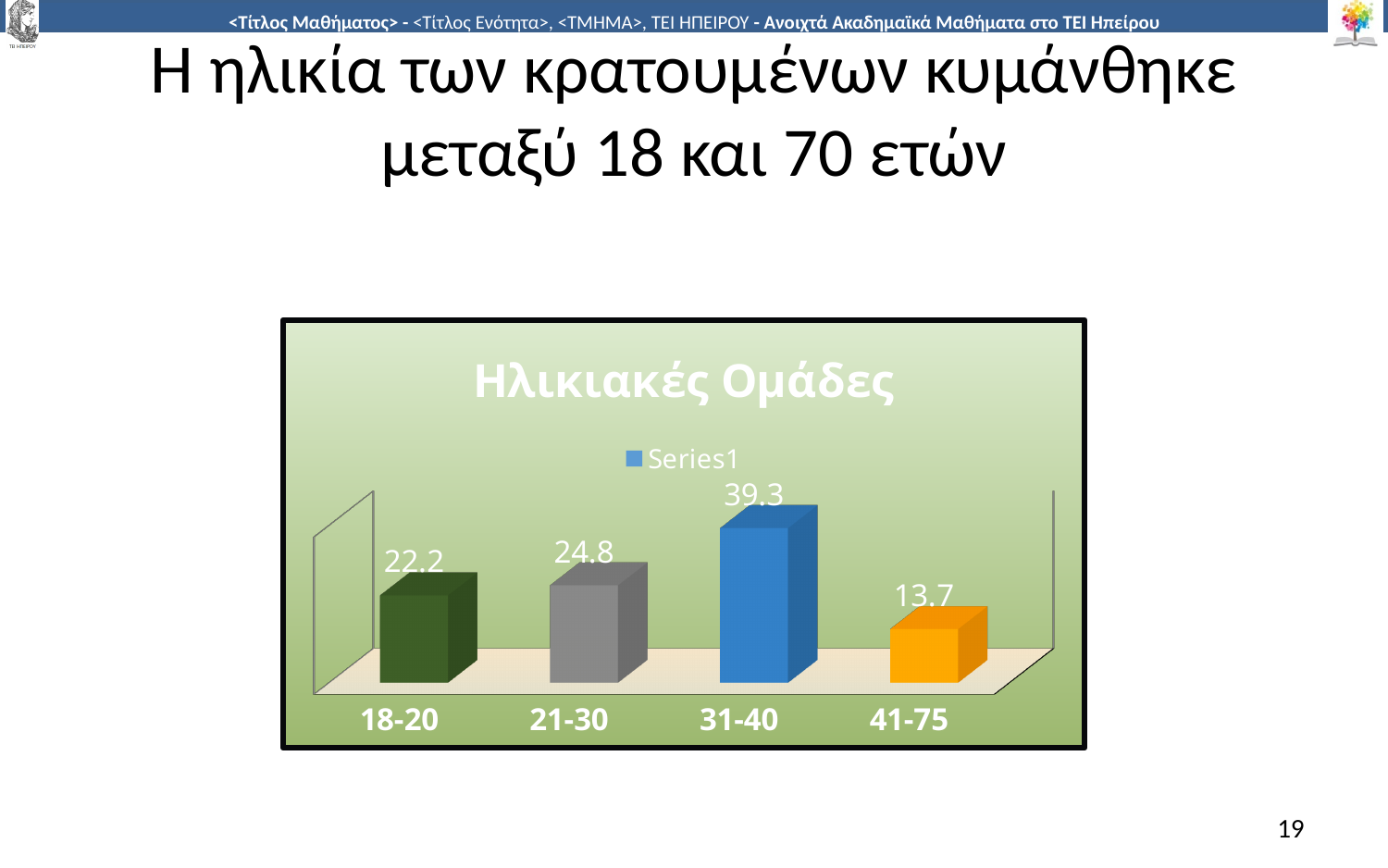
Which is larger, the value for 18-20 or the value for 41-75? 18-20 How many age groups are shown in the chart? 4 Which age group has the highest value? 31-40 What is the value for the 31-40 age group? 39.3 What is the value for the 21-30 age group? 24.8 What is the difference between the values for 31-40 and 41-75? 25.6 What is the value for the 18-20 age group? 22.2 What kind of chart is shown on the slide? bar chart What is the value for the 41-75 age group? 13.7 What is the title of the chart? Ηλικιακές Ομάδες Which age group has the lowest value? 41-75 What is the difference between the values for 21-30 and 18-20? 2.6